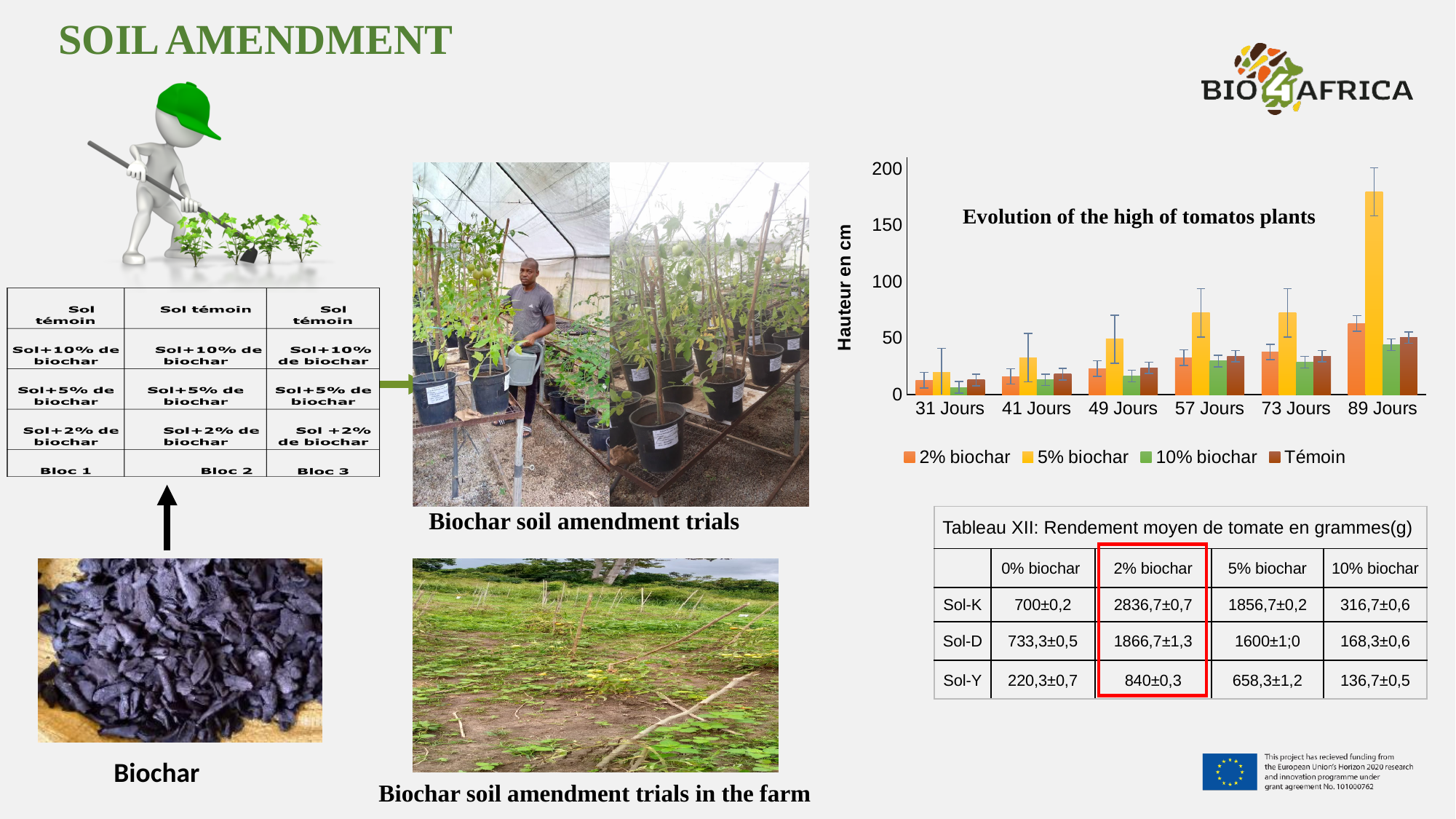
Is the value for 5% biochar at 89 Jours greater or less than 150? greater What kind of chart is shown on the slide? bar chart What is the label of the vertical axis of the chart? Hauteur en cm Which series has the tallest bar at 89 Jours? 5% biochar Is the value for 2% biochar at 57 Jours greater or less than 50? less How many series does the chart legend list? 4 Is the value for 10% biochar at 31 Jours greater or less than 50? less What is the title of the chart? Evolution of the high of tomatos plants Which series has the shortest bar at 31 Jours? 10% biochar At 41 Jours, which is larger: the 5% biochar bar or the Témoin bar? 5% biochar Do the values for 2% biochar rise or fall from 31 Jours to 89 Jours? rise How many time-point categories are shown on the x axis of the chart? 6